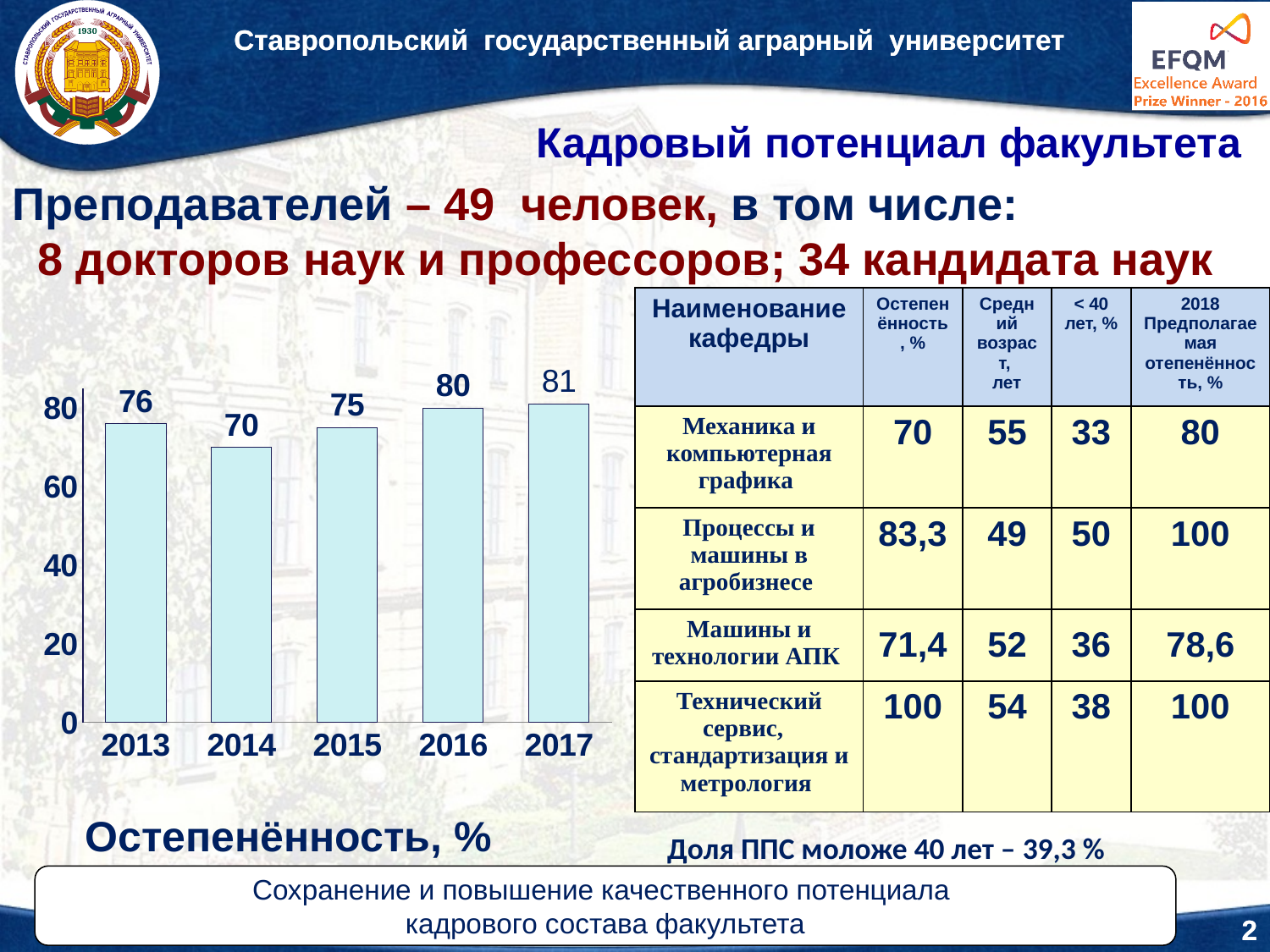
Which is larger in the bar chart, the value for 2013 or the value for 2015? 2013 Which year has the highest value in the bar chart? 2017 Is the value for 2014 in the bar chart greater or less than 60? greater What kind of chart is shown on the slide? bar chart What is the value for 2017 in the bar chart? 81 What is the value for 2014 in the bar chart? 70 Which year has the lowest value in the bar chart? 2014 What is the value for 2013 in the bar chart? 76 What is the difference between the values for 2016 and 2015 in the bar chart? 5 How many years are shown on the x axis of the bar chart? 5 What is the difference between the values for 2017 and 2014 in the bar chart? 11 What is the label shown beneath the bar chart? Остепенённость, %